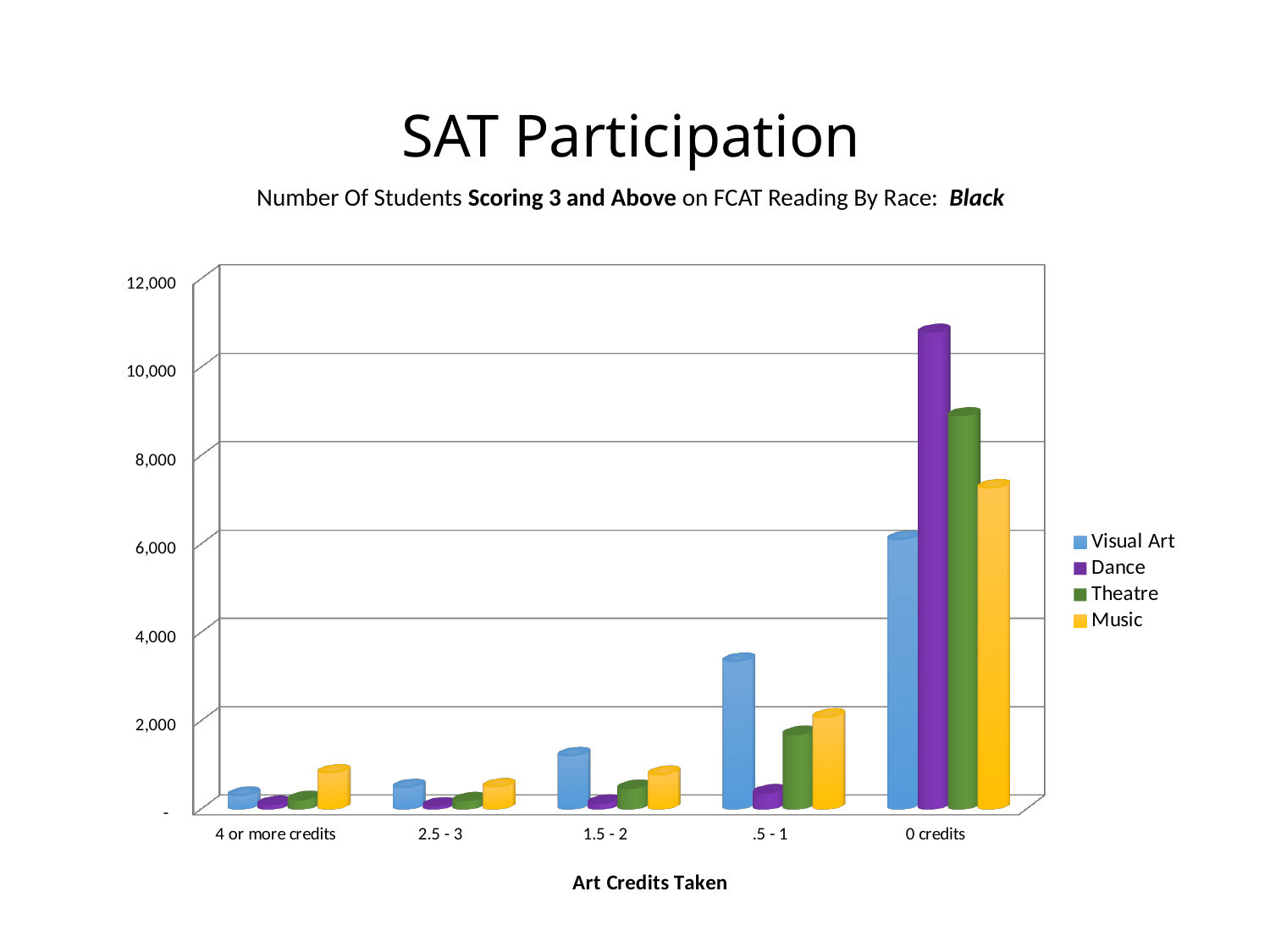
What kind of chart is shown on the slide? bar chart Is the Visual Art value for .5 - 1 credits greater or less than 2,000? greater How many categories are shown on the x axis? 5 What is the title of the x axis? Art Credits Taken For .5 - 1 credits, which is larger: Visual Art or Music? Visual Art What colour represents Music in the legend? yellow Is the Visual Art value for 0 credits greater or less than 8,000? less Is the Dance value for 0 credits greater or less than 10,000? greater How many series does the legend list? 4 Which category has the highest Dance value? 0 credits Do the Visual Art values rise or fall moving from 4 or more credits to 0 credits along the x axis? rise For 0 credits, which is larger: Dance or Theatre? Dance